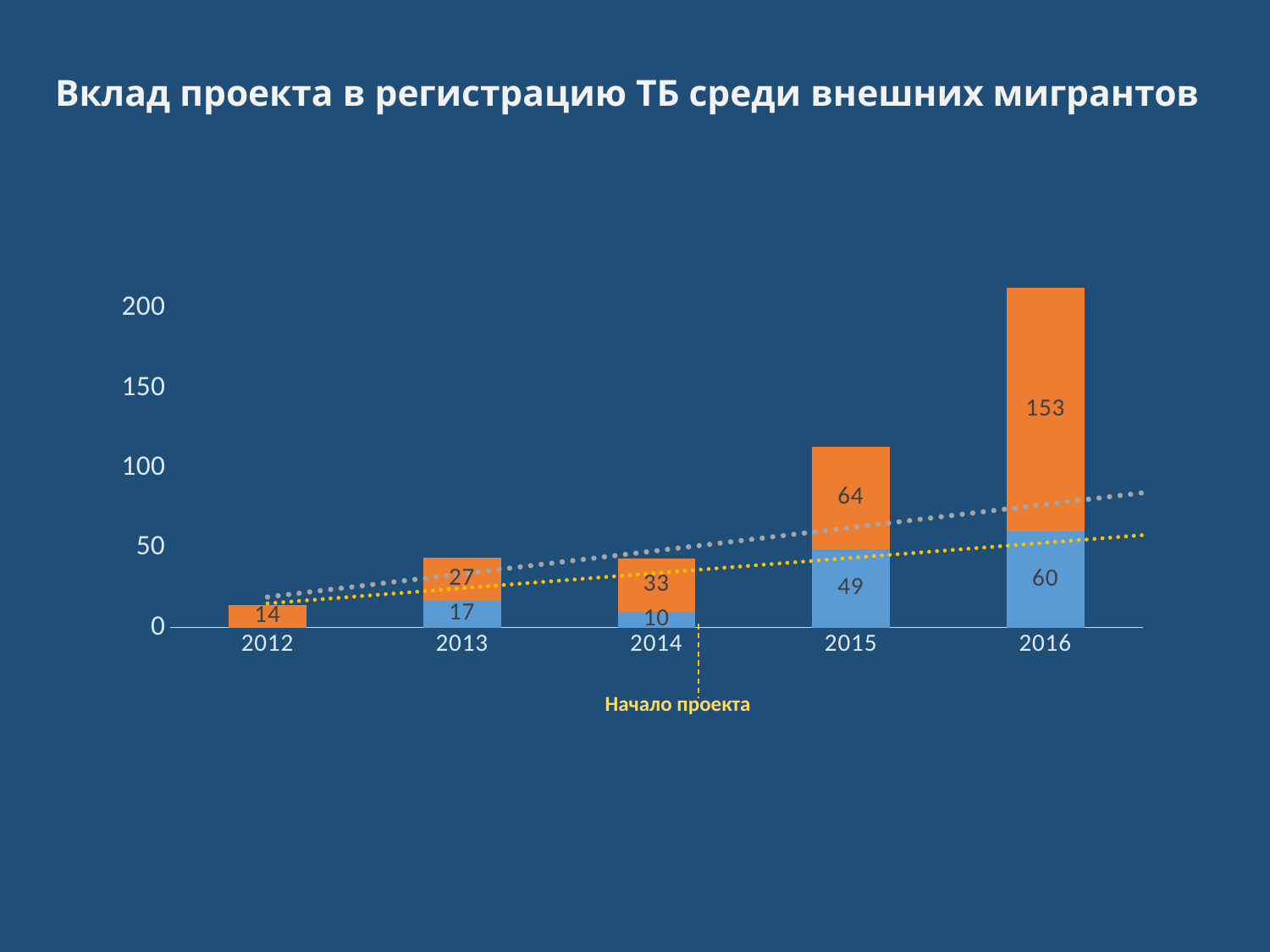
What is the total of the stacked bar for 2015? 113 What is the difference between the orange segment values for 2016 and 2015? 89 Which year has the highest orange segment value? 2016 How many years are shown on the x axis? 5 What is the total of the stacked bar for 2016? 213 What is the value of the orange segment for 2016? 153 Which year has the lowest blue segment value among the years where a blue segment is labelled? 2014 What is the value of the blue segment for 2014? 10 What is the title of the chart? Вклад проекта в регистрацию ТБ среди внешних мигрантов What is the value of the orange segment for 2012? 14 What is the value of the blue segment for 2015? 49 Which is larger, the blue segment for 2016 or the blue segment for 2013? 2016